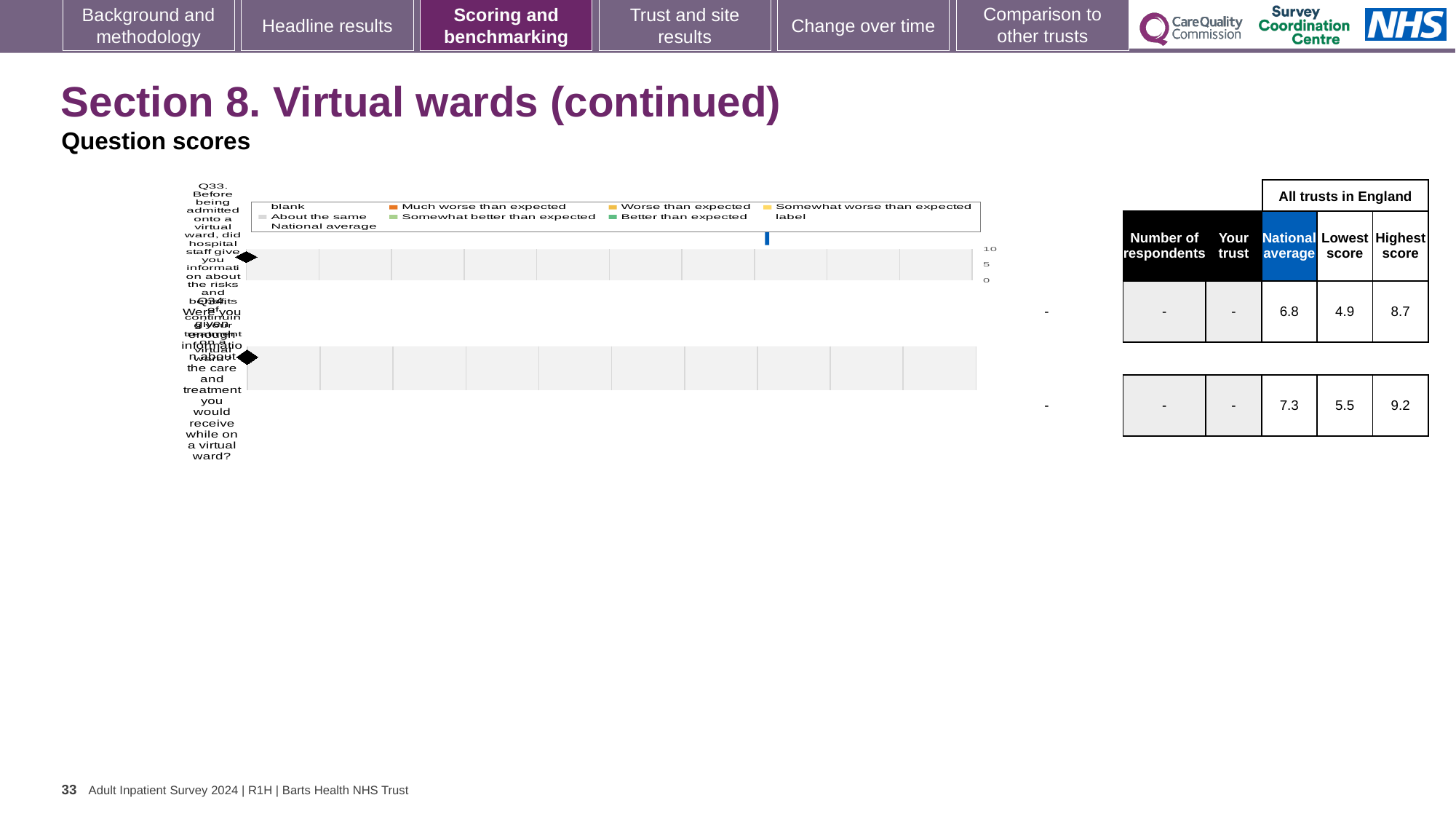
How many question categories (rows) does the chart show? 2 In the table to the right of the chart, what is the highest score across all trusts in England for Q34? 9.2 In the table to the right of the chart, what is the difference between the highest and lowest scores for Q33? 3.8 In the table to the right of the chart, what is the lowest score across all trusts in England for Q33? 4.9 In the table to the right of the chart, what is the national average score for Q34? 7.3 In the table to the right of the chart, which question has the higher national average, Q33 or Q34? Q34 Which legend entry is shown in orange? Much worse than expected What is the highest tick value shown on the chart's x axis? 10 In the table to the right of the chart, what is the difference between the highest and lowest scores for Q34? 3.7 What kind of chart is shown on the slide? bar chart In the table to the right of the chart, what is the national average score for Q33? 6.8